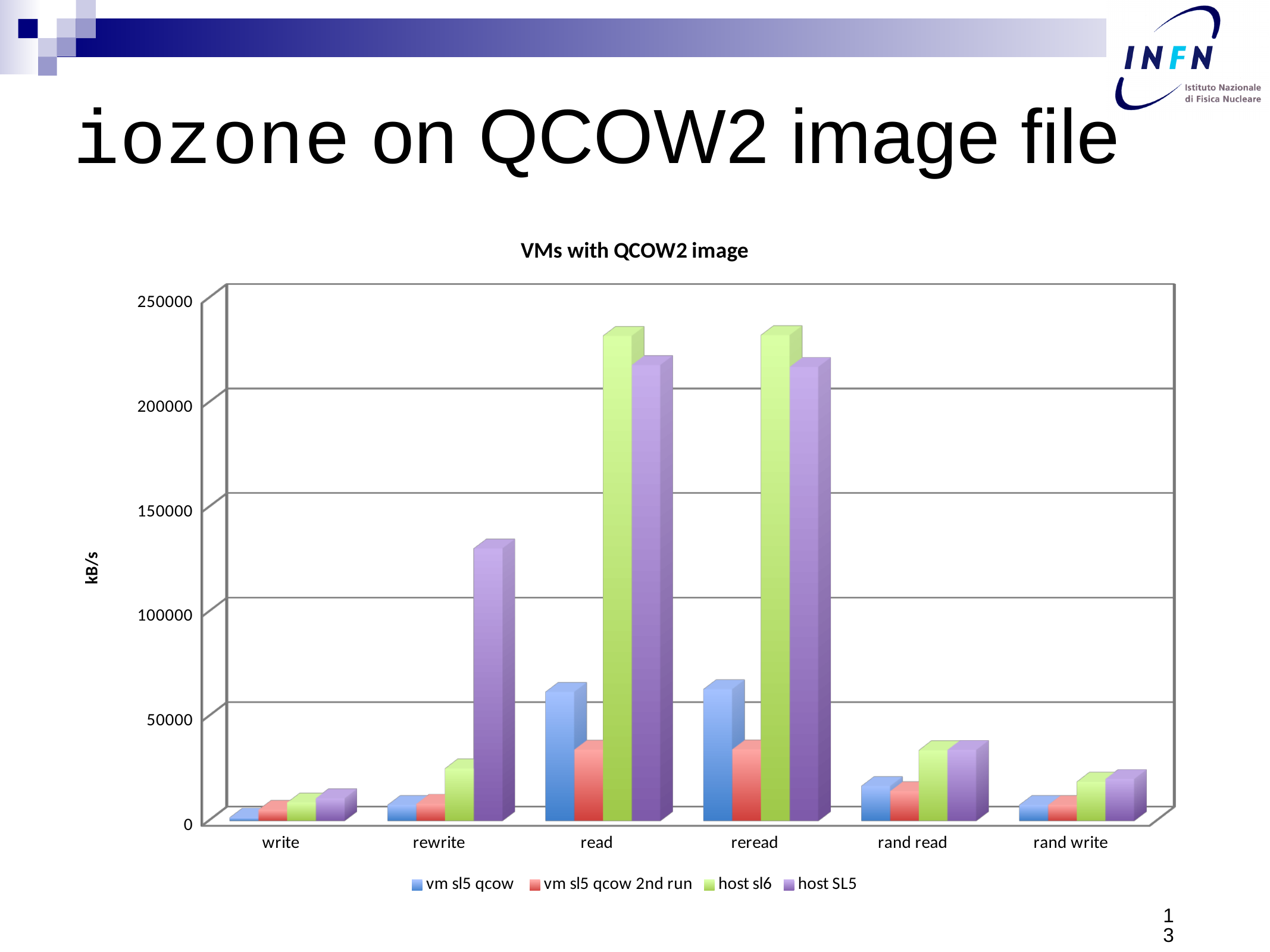
Which category has the lowest value for the vm sl5 qcow series? write What is the label on the vertical axis of the chart? kB/s Is the value for vm sl5 qcow in the read category greater or less than 50000? greater What kind of chart is shown on the slide? bar chart In the read category, which is larger: host sl6 or vm sl5 qcow? host sl6 Is the value for host sl6 in the rand read category greater or less than 50000? less Is the value for host SL5 in the rewrite category greater or less than 100000? greater How many categories are shown on the x axis of the chart? 6 What is the title of the chart? VMs with QCOW2 image In the rewrite category, which is larger: host SL5 or host sl6? host SL5 How many series does the chart legend list? 4